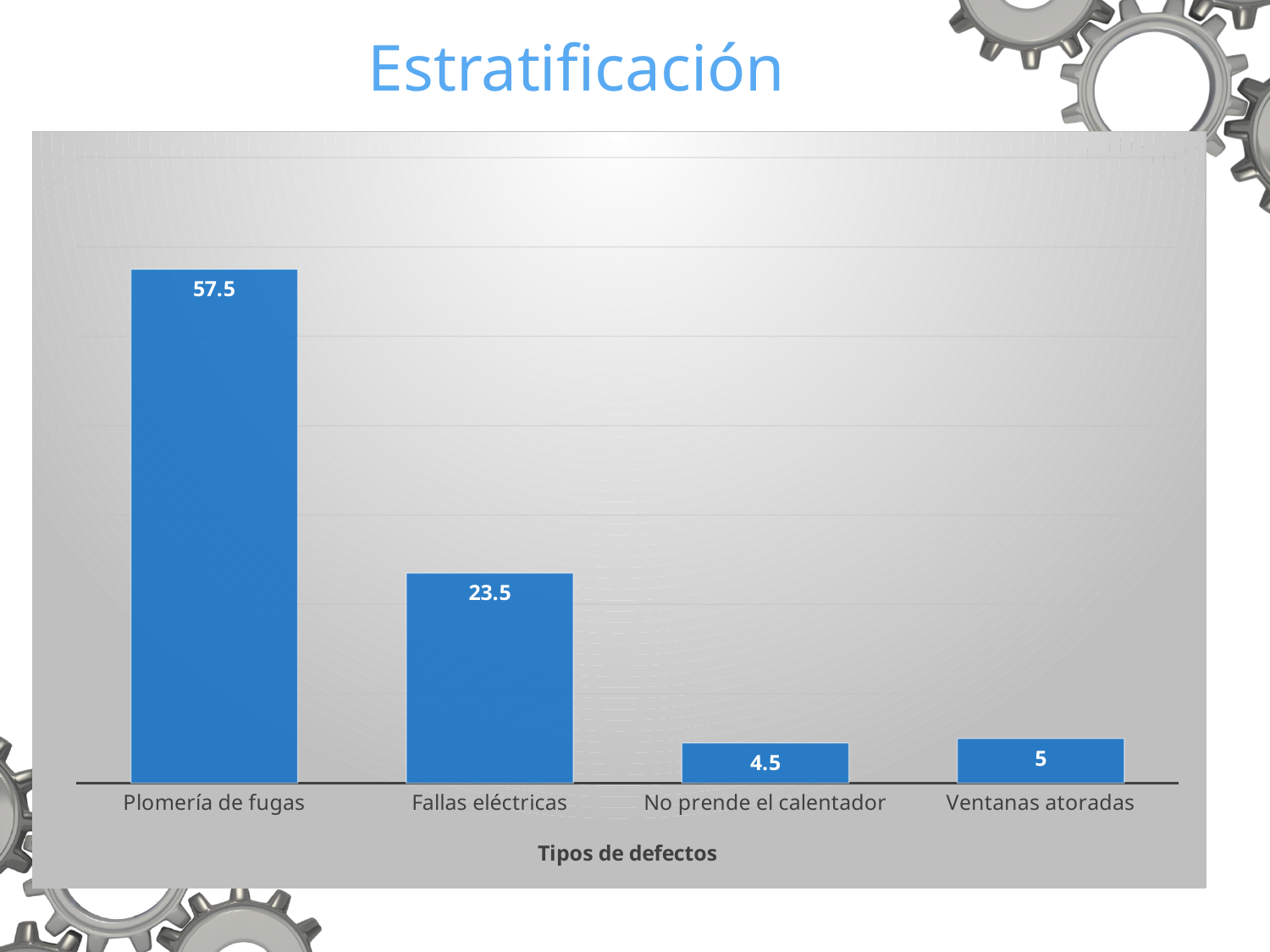
What is the x-axis title of the chart? Tipos de defectos Which type of defect has the lowest value? No prende el calentador What is the difference between the values for Plomería de fugas and Fallas eléctricas? 34 What is the value for No prende el calentador? 4.5 What is the value for Ventanas atoradas? 5 Which type of defect has the highest value? Plomería de fugas What kind of chart is shown on the slide? Bar chart What is the value for Plomería de fugas? 57.5 What is the difference between the values for Ventanas atoradas and No prende el calentador? 0.5 Which is larger, the value for Fallas eléctricas or the value for Ventanas atoradas? Fallas eléctricas What is the value for Fallas eléctricas? 23.5 How many types of defects are shown in the chart? 4